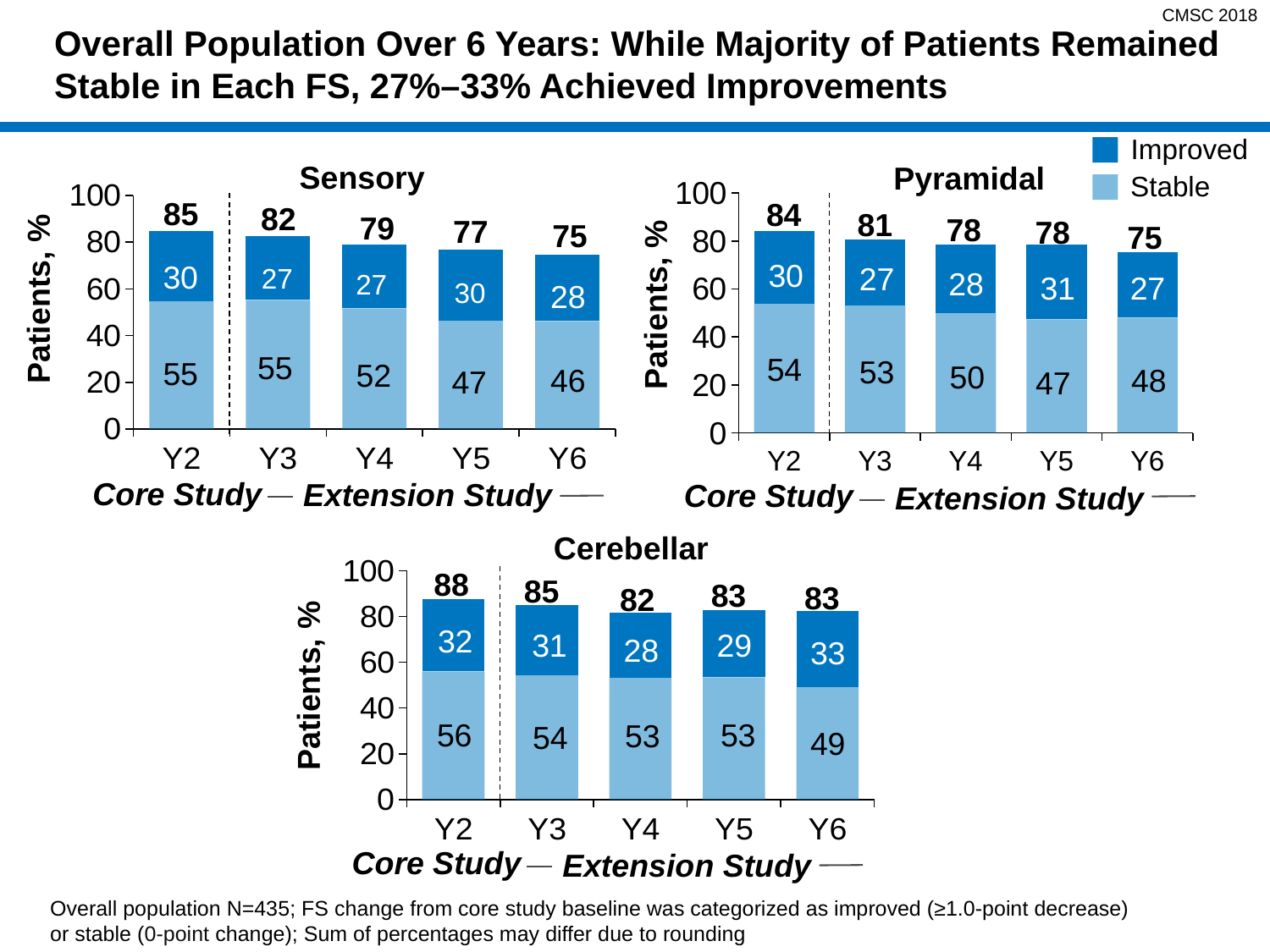
In the Pyramidal chart, what is the difference between the Stable values for Y2 and Y6? 6 In the Sensory chart, do the total bar values rise or fall from Y2 to Y6? fall In the Cerebellar chart, what is the total of the Y4 bar as labelled? 82 In the Cerebellar chart, which year has the highest total bar? Y2 How many years are shown on the x axis of the Pyramidal chart? 5 In the Pyramidal chart, what is the Improved value for Y5? 31 What kind of chart is the Sensory chart? Stacked bar chart In the Cerebellar chart, what is the Improved value for Y6? 33 How many series does the legend list? 2 In the Sensory chart, which year has the lowest Stable value? Y6 In the Sensory chart, is the Stable value for Y3 larger or smaller than the Stable value for Y5? larger In the Sensory chart, what is the Stable value for Y2? 55